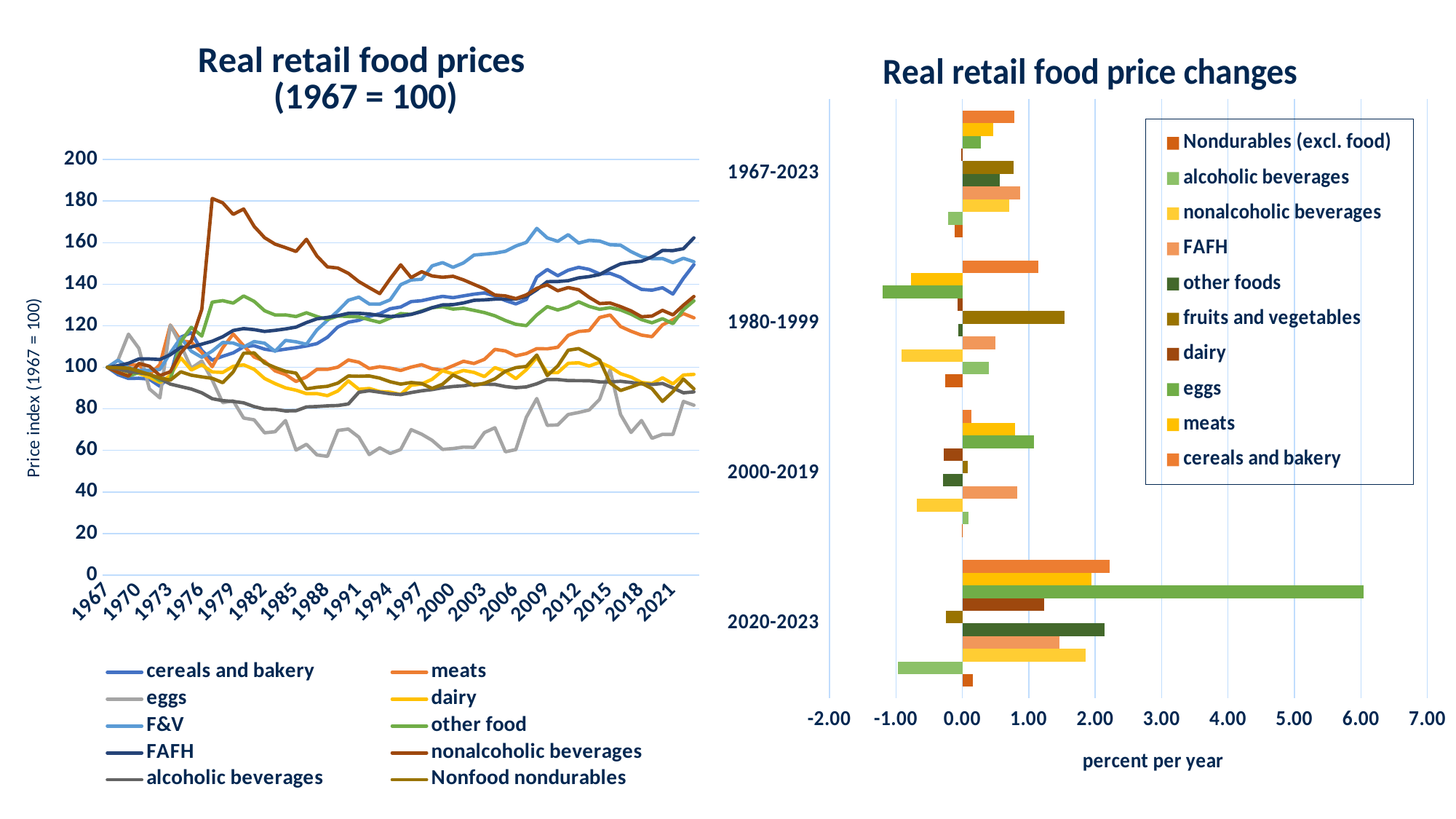
In the right chart "Real retail food price changes", which series has the lowest value for 1980-1999? eggs What kind of chart is the right chart titled "Real retail food price changes"? bar chart In the right chart "Real retail food price changes", which is larger for 2020-2023: other foods or dairy? other foods How many series does the legend of the left chart "Real retail food prices (1967 = 100)" list? 10 In the left chart "Real retail food prices (1967 = 100)", is the peak value of nonalcoholic beverages around 1978 greater or less than 160? greater What is the x-axis label of the right chart "Real retail food price changes"? percent per year How many time periods are shown on the vertical axis of the right chart "Real retail food price changes"? 4 In the right chart "Real retail food price changes", is the value for fruits and vegetables in 1980-1999 greater or less than 1.00? greater In the left chart "Real retail food prices (1967 = 100)", does the FAFH line generally rise or fall from 1967 to the end of the series? rise In the right chart "Real retail food price changes", which series has the largest value for 2020-2023? eggs In the right chart "Real retail food price changes", is the value for eggs in 2020-2023 greater or less than 5.00? greater What kind of chart is the left chart titled "Real retail food prices (1967 = 100)"? line chart